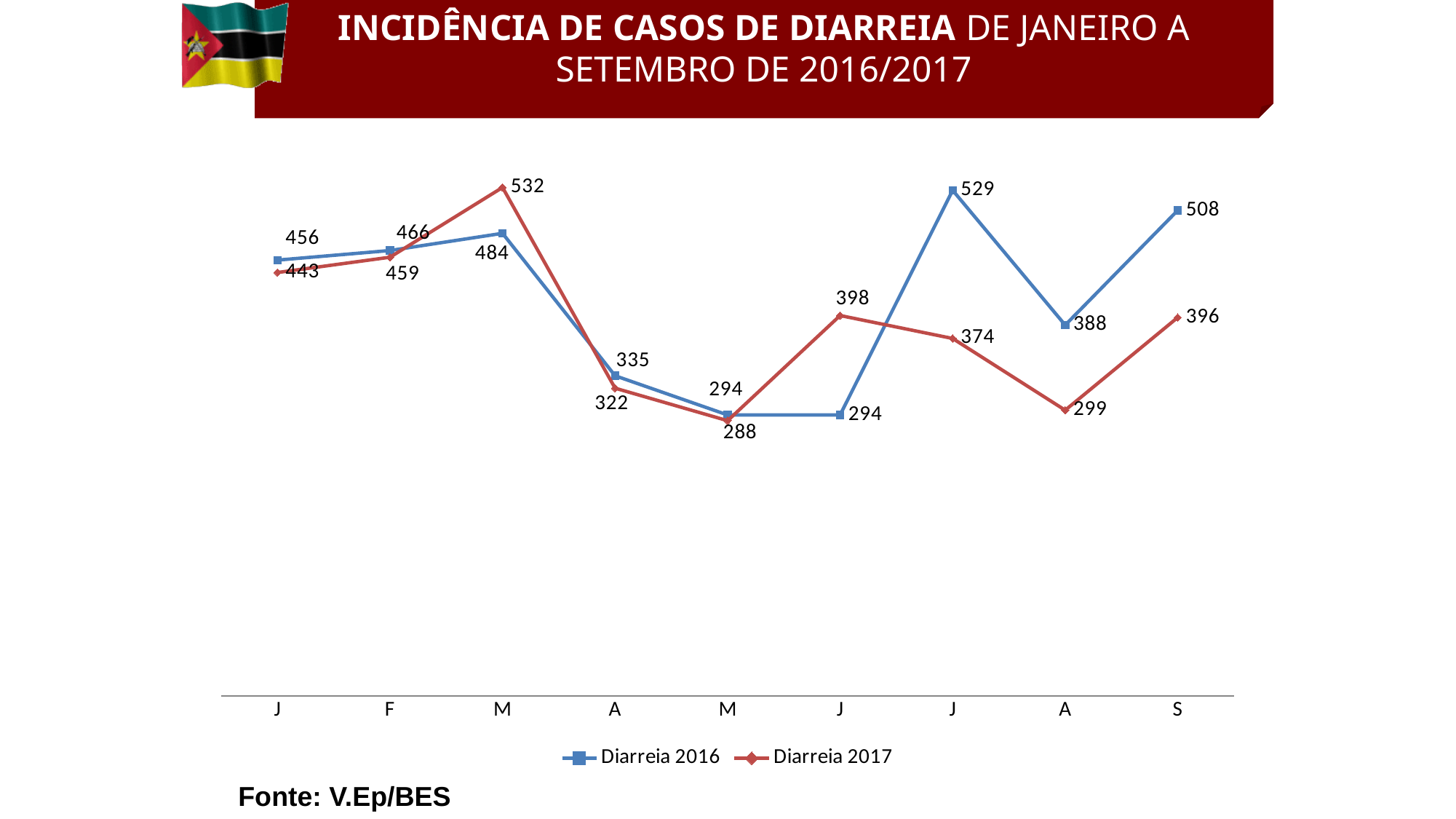
In which month does Diarreia 2017 reach its lowest value? May (the fifth M), 288 Which series has the higher value in the third month (March, M)? Diarreia 2017 Does Diarreia 2016 rise or fall from the third month (March) to the fifth month (May)? fall What colour is the Diarreia 2017 line? red How many months are plotted along the x axis? 9 What is the difference between Diarreia 2016 and Diarreia 2017 in the seventh month (July, J)? 155 What is the value for Diarreia 2017 in the sixth month (June, J)? 398 What type of chart is shown on the slide? line chart How many series does the legend list? 2 In which month does Diarreia 2016 reach its highest value? July (the seventh J), 529 What is the value for Diarreia 2017 in the last month (September, S)? 396 What is the value for Diarreia 2016 in the third month (March, M)? 484